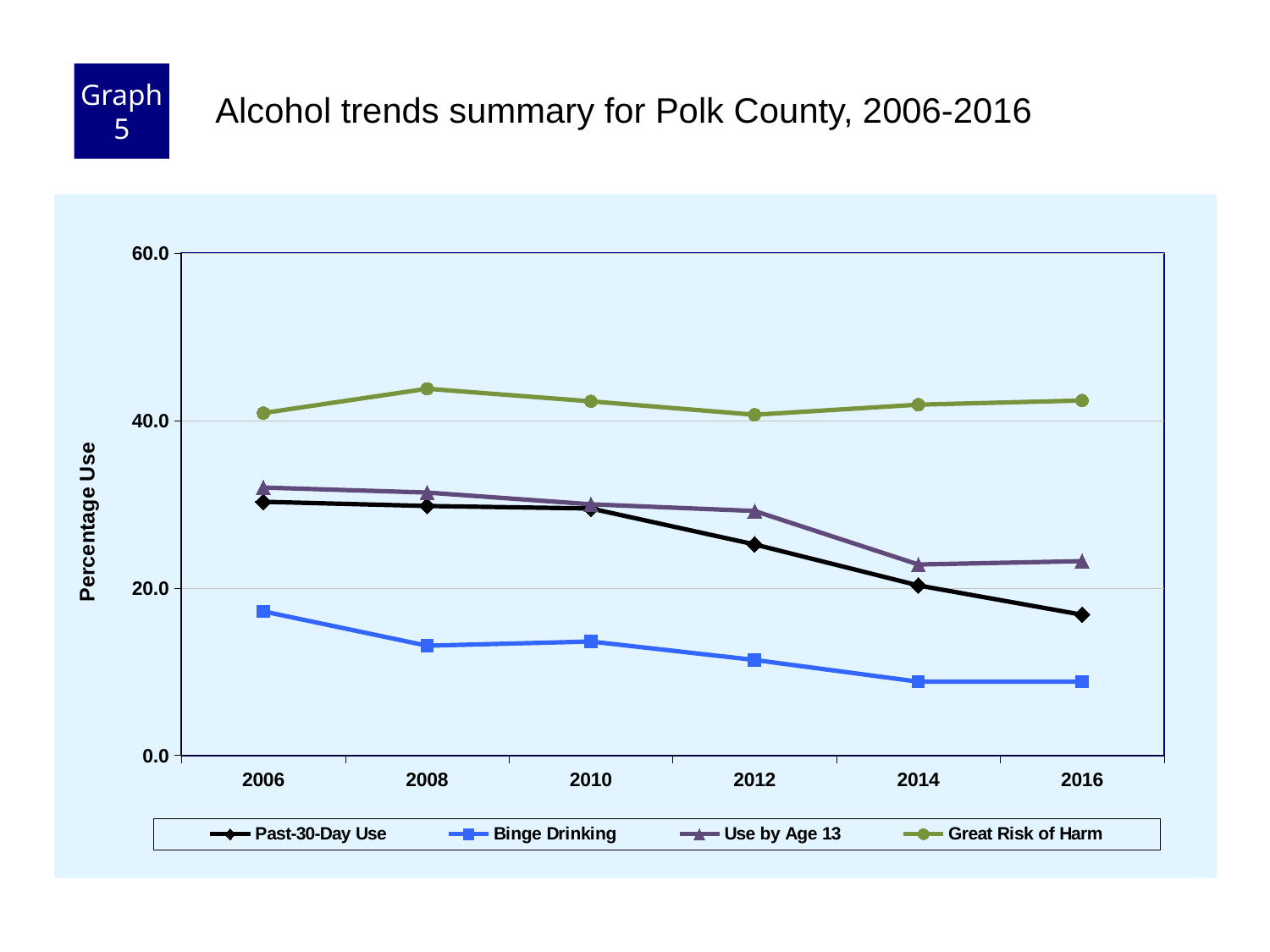
Which series has the lowest values across the whole chart? Binge Drinking Which series has the highest values across the whole chart? Great Risk of Harm In which year is the Past-30-Day Use value lowest? 2016 How many series does the legend list? 4 What kind of chart is shown on the slide? line chart Does the Past-30-Day Use series rise or fall from 2006 to 2016? fall Which is larger in 2012, Great Risk of Harm or Binge Drinking? Great Risk of Harm What is the label on the y axis? Percentage Use Is the value for Past-30-Day Use in 2016 greater or less than 20.0? less In which year is the Binge Drinking value highest? 2006 Is the value for Great Risk of Harm in 2008 greater or less than 40.0? greater How many years are plotted along the x axis? 6